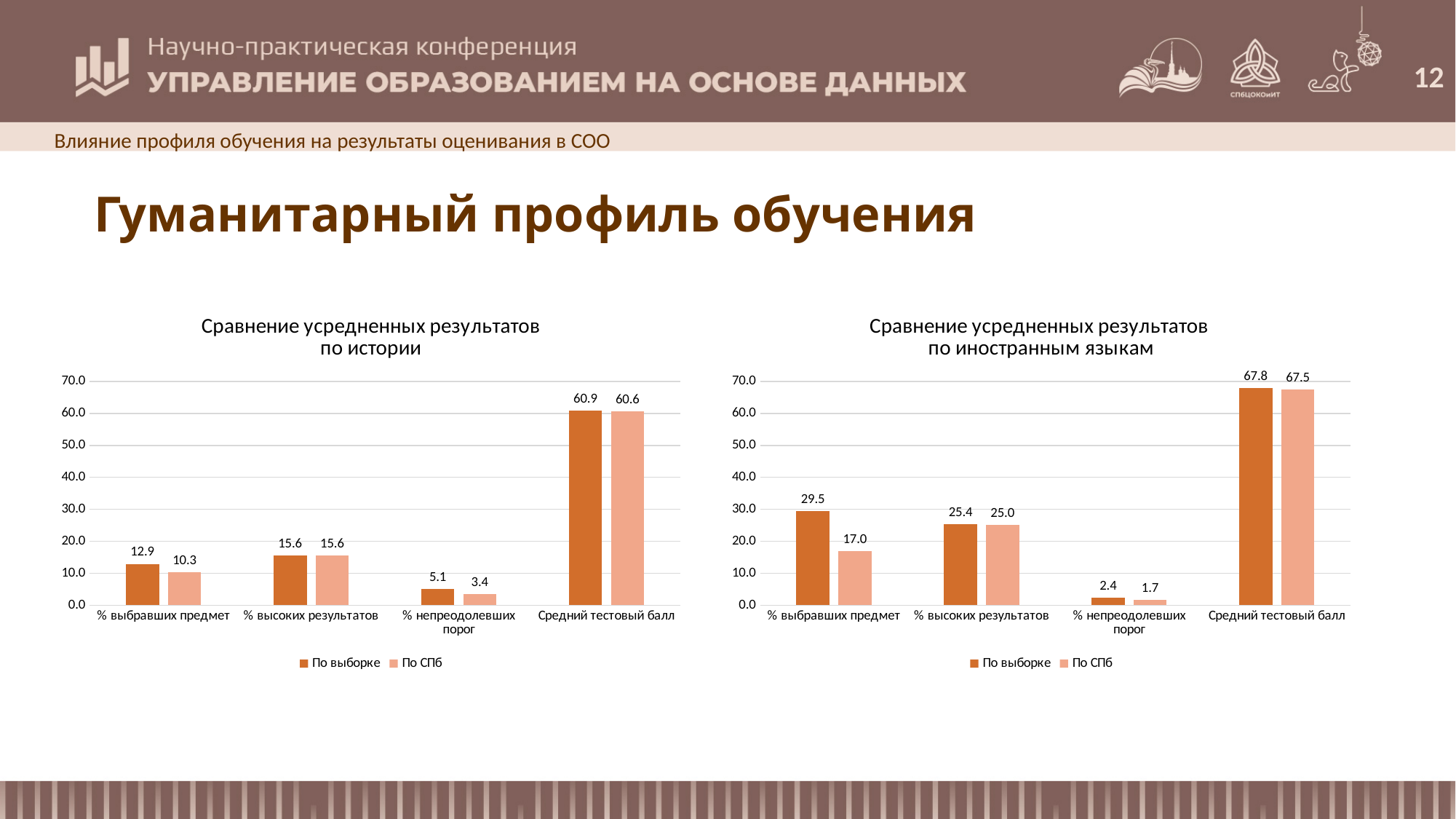
In the left chart 'Сравнение усредненных результатов по истории', what is the difference between 'По выборке' and 'По СПб' for '% выбравших предмет'? 2.6 In the left chart 'Сравнение усредненных результатов по истории', what is the value of 'По СПб' for '% непреодолевших порог'? 3.4 In the left chart 'Сравнение усредненных результатов по истории', which category has the highest value for 'По выборке'? Средний тестовый балл In the left chart 'Сравнение усредненных результатов по истории', what is the value of 'По выборке' for '% выбравших предмет'? 12.9 In the left chart 'Сравнение усредненных результатов по истории', which is larger for '% непреодолевших порог': 'По выборке' or 'По СПб'? По выборке How many series does the legend of the left chart 'Сравнение усредненных результатов по истории' list? 2 In the right chart 'Сравнение усредненных результатов по иностранным языкам', what is the value of 'По выборке' for 'Средний тестовый балл'? 67.8 How many categories are shown on the x axis of the right chart 'Сравнение усредненных результатов по иностранным языкам'? 4 In the right chart 'Сравнение усредненных результатов по иностранным языкам', what is the difference between 'По выборке' and 'По СПб' for '% выбравших предмет'? 12.5 In the right chart 'Сравнение усредненных результатов по иностранным языкам', what is the value of 'По СПб' for '% выбравших предмет'? 17.0 In the right chart 'Сравнение усредненных результатов по иностранным языкам', which category has the lowest value for 'По СПб'? % непреодолевших порог What type of chart is the right chart 'Сравнение усредненных результатов по иностранным языкам'? Bar chart